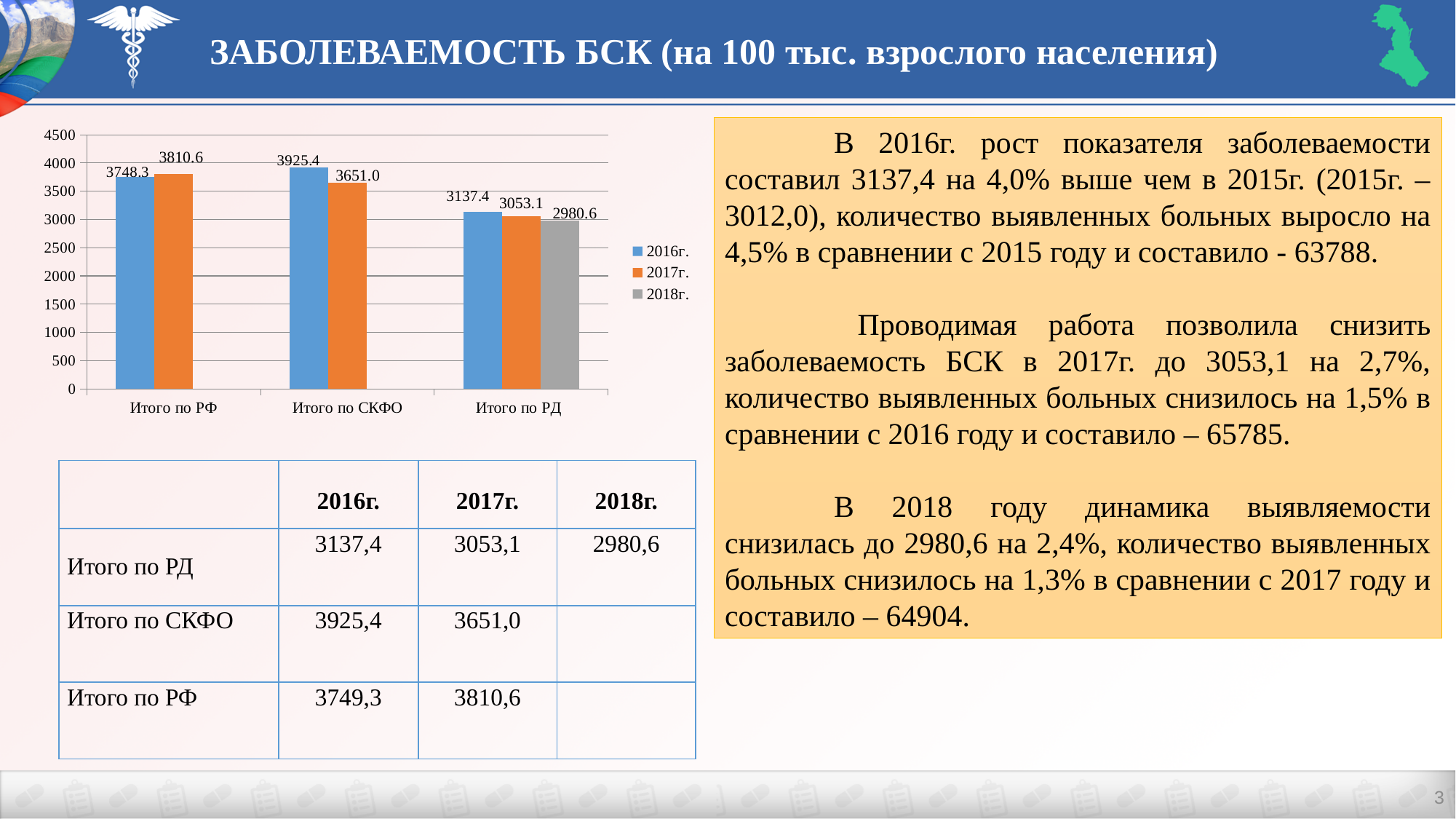
Which category has the lowest value for 2017г.? Итого по РД Do the values for Итого по РД rise or fall from 2016г. to 2018г.? fall What is the value for 2018г. in the category Итого по РД? 2980.6 What is the value for 2017г. in the category Итого по СКФО? 3651.0 How many series does the chart legend list? 3 Which is larger for Итого по РФ: the 2016г. value or the 2017г. value? 2017г. Which category has the highest value for 2016г.? Итого по СКФО What is the value for 2016г. in the category Итого по РД? 3137.4 What is the difference between the 2016г. and 2017г. values for Итого по СКФО? 274.4 What type of chart is shown on the slide? bar chart What is the value for 2017г. in the category Итого по РФ? 3810.6 How many categories are shown on the x axis of the chart? 3